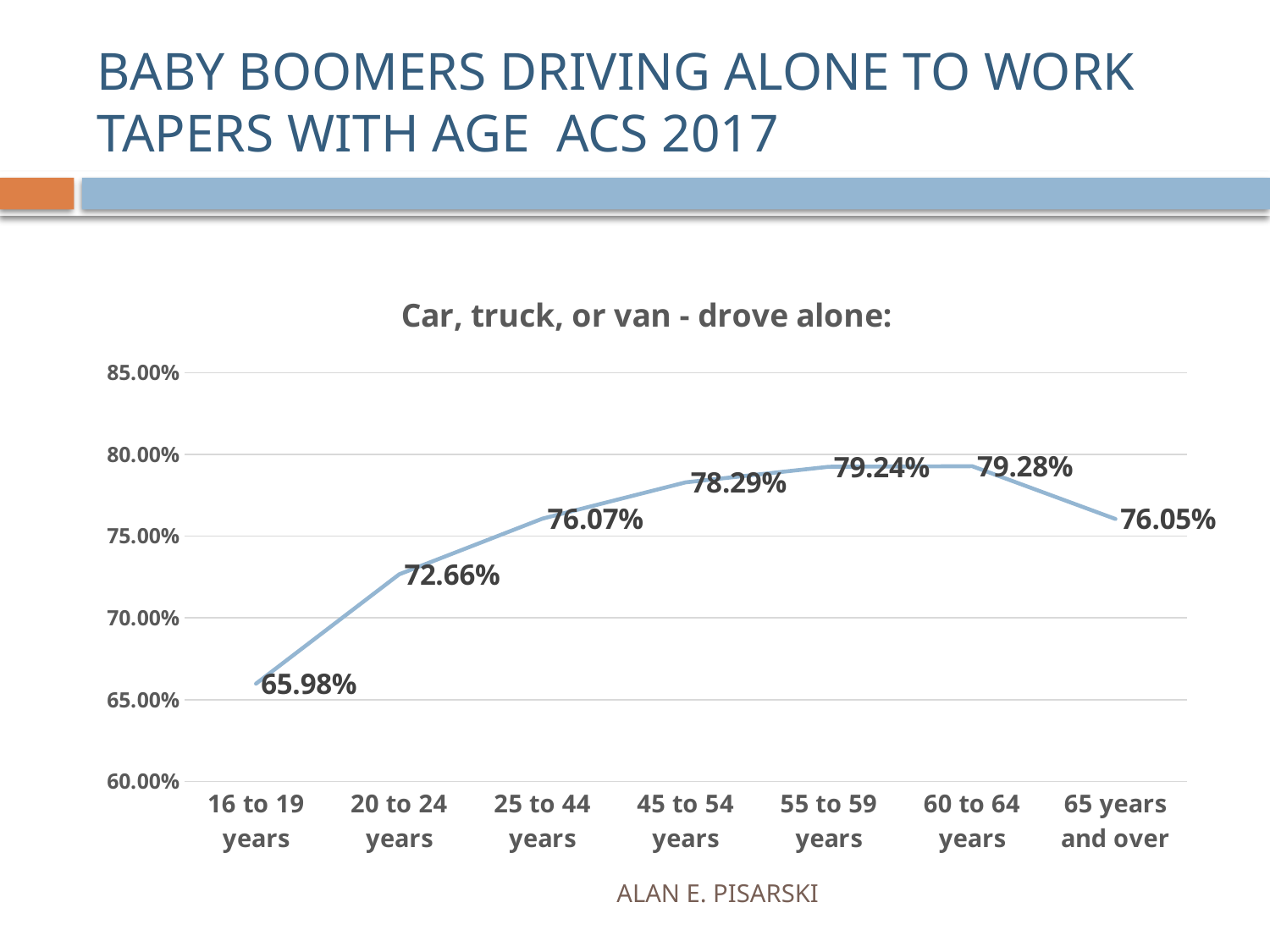
What kind of chart is shown on the slide? line chart What is the difference between the values for 60 to 64 years and 16 to 19 years? 13.30% Which age group has the lowest value? 16 to 19 years What is the value for 45 to 54 years? 78.29% Which is larger, the value for 20 to 24 years or the value for 45 to 54 years? 45 to 54 years Is the value for 16 to 19 years greater or less than 70.00%? less What is the title of the chart? Car, truck, or van - drove alone: What is the difference between the values for 25 to 44 years and 20 to 24 years? 3.41% How many age groups are plotted on the chart? 7 What is the value for 65 years and over? 76.05% Which age group has the highest value? 60 to 64 years What is the value for 16 to 19 years? 65.98%